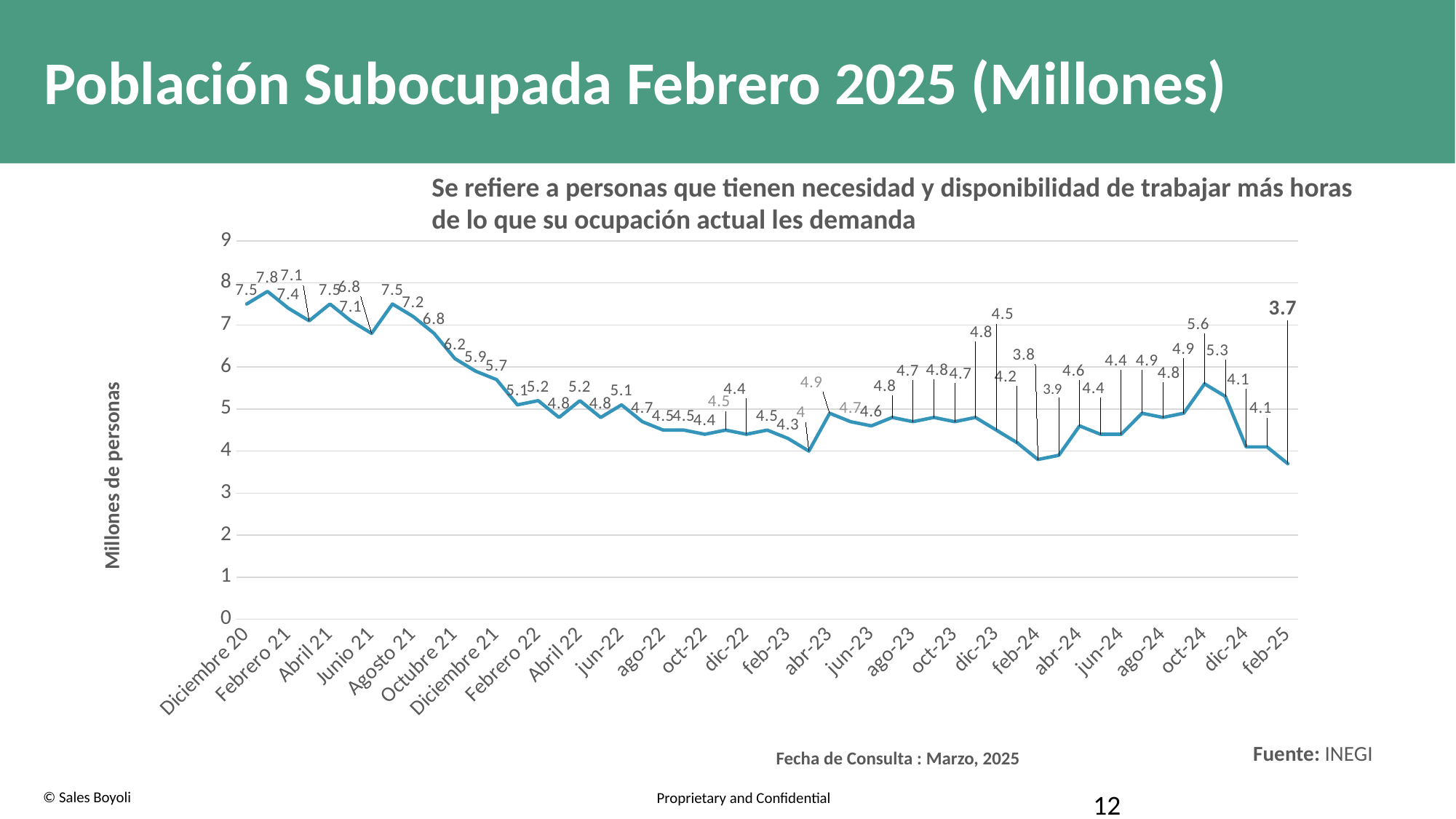
What is the difference between the value for Diciembre 20 and the value for feb-25? 3.8 Which is larger, the value for Diciembre 20 or the value for feb-25? Diciembre 20 Which x-axis category has the lowest value? feb-25 Is the value for feb-25 greater or less than 4? less What type of chart is shown on the slide? line chart What is the value for feb-25? 3.7 What is the value for oct-24? 5.6 What is the title of the slide? Población Subocupada Febrero 2025 (Millones) What is the highest value plotted on the chart? 7.8 What is the label of the y axis? Millones de personas What is the value for Diciembre 20? 7.5 Overall, do the values rise or fall from Diciembre 20 to feb-25? fall